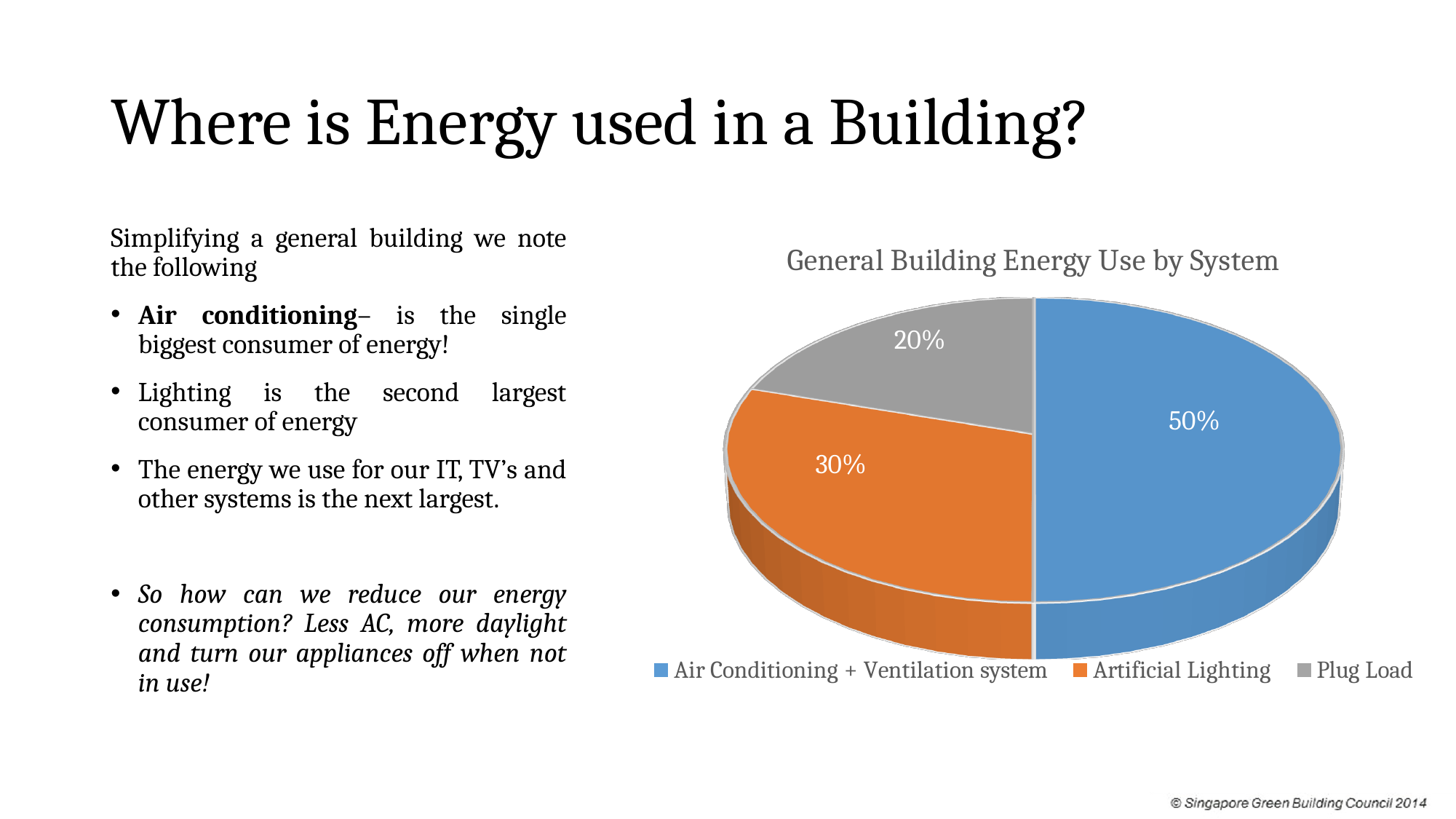
What share of energy use does Air Conditioning + Ventilation system account for? 50% What is the difference in percentage points between Air Conditioning + Ventilation system and Artificial Lighting? 20 What share of energy use does Plug Load account for? 20% How many categories does the pie chart show? 3 Which colour represents Plug Load in the chart? Grey What is the title of the chart? General Building Energy Use by System What kind of chart is shown on the slide? Pie chart Which system accounts for the smallest share of energy use? Plug Load What share of energy use does Artificial Lighting account for? 30% Which is larger, the share for Artificial Lighting or the share for Plug Load? Artificial Lighting Which system accounts for the largest share of energy use? Air Conditioning + Ventilation system What is the difference in percentage points between Artificial Lighting and Plug Load? 10